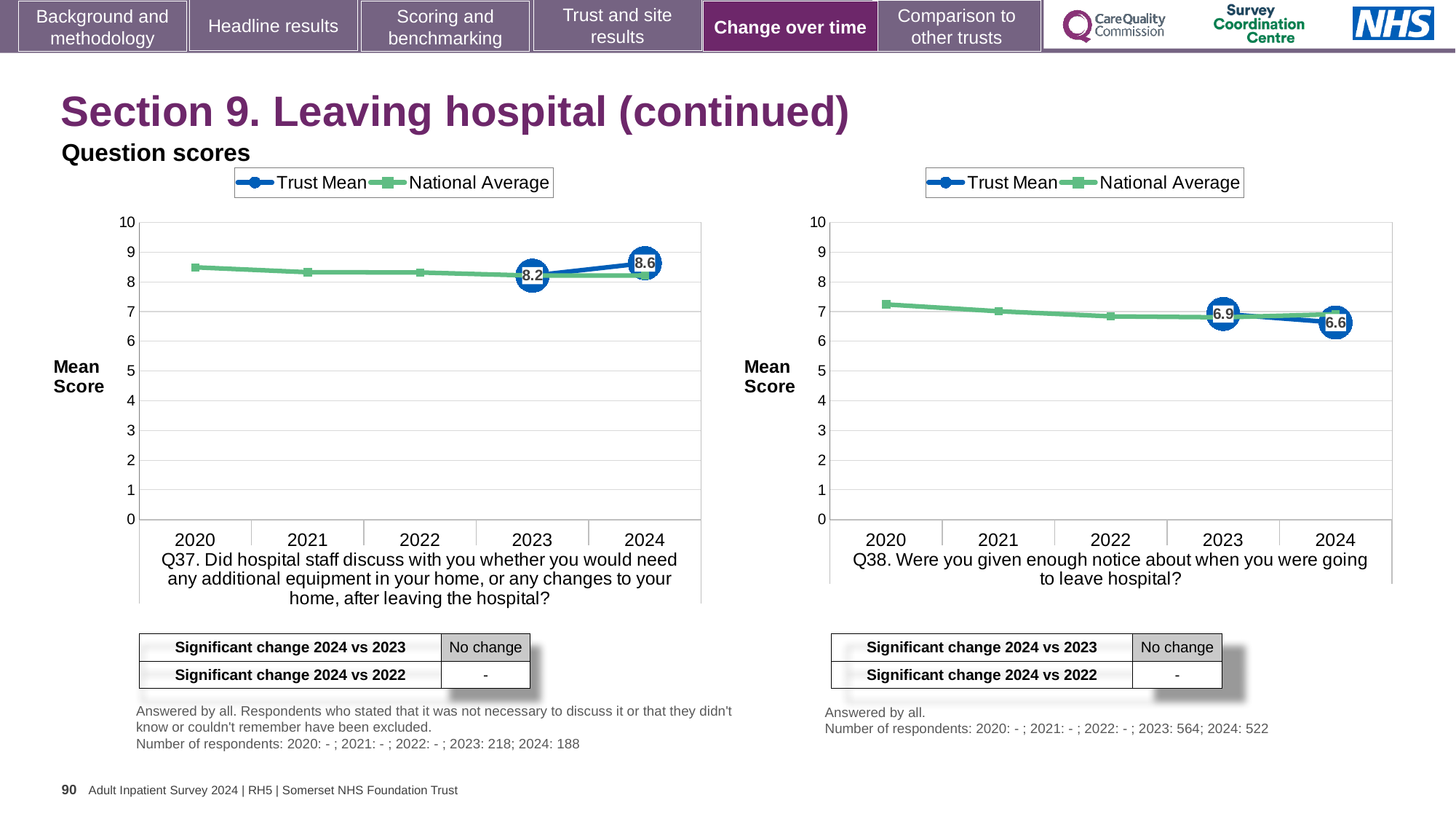
On the Q38 chart (right), what is the Trust Mean score for 2024? 6.6 On the Q38 chart (right), what is the difference between the Trust Mean in 2023 and in 2024? 0.3 On the Q37 chart (left), is the National Average for 2020 greater or less than 8? greater On the Q38 chart (right), what is the Trust Mean score for 2023? 6.9 On the Q37 chart (left), is the Trust Mean for 2024 higher or lower than for 2023? higher How many series does the legend of the Q38 chart (right) list? 2 On the Q38 chart (right), did the Trust Mean rise or fall from 2023 to 2024? fall On the Q38 chart (right), is the National Average for 2020 greater or less than 8? less On the Q37 chart (left), what is the Trust Mean score for 2023? 8.2 On the Q37 chart (left), what is the Trust Mean score for 2024? 8.6 On the Q37 chart (left), by how much did the Trust Mean change from 2023 to 2024? 0.4 What type of chart is used on this slide? line chart